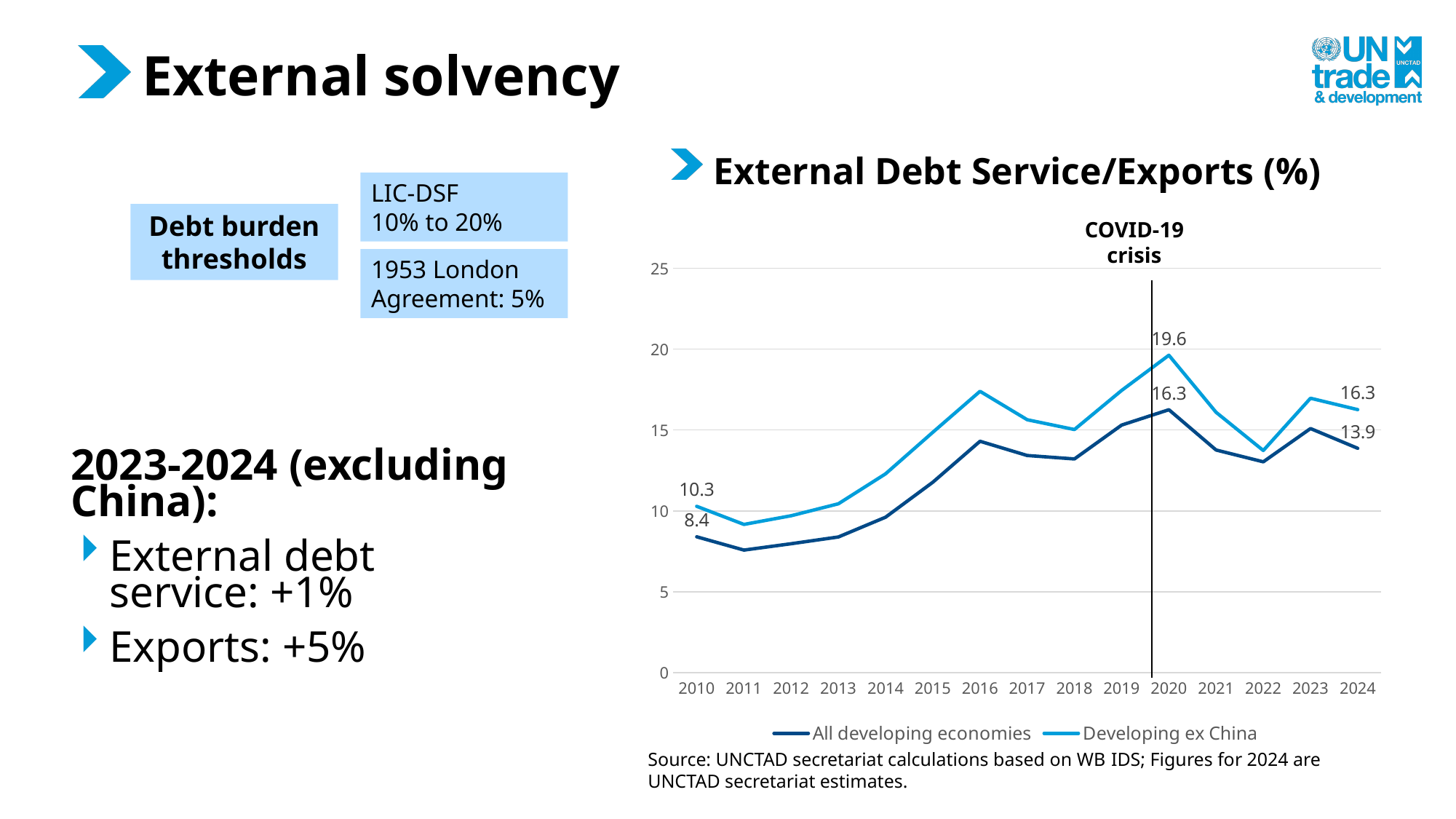
How many series does the legend list? 2 What event does the vertical line on the chart mark? COVID-19 crisis What is the value for All developing economies in 2010? 8.4 Is the value for Developing ex China in 2016 greater or less than 15? greater Which series has the higher value in 2024, All developing economies or Developing ex China? Developing ex China Is the value for All developing economies in 2011 greater or less than 10? less What is the value for Developing ex China in 2024? 16.3 What is the difference between Developing ex China and All developing economies in 2020? 3.3 What kind of chart is shown on the slide? line chart What is the value for Developing ex China in 2020? 19.6 What is the difference between the Developing ex China values in 2010 and 2020? 9.3 What is the value for All developing economies in 2024? 13.9